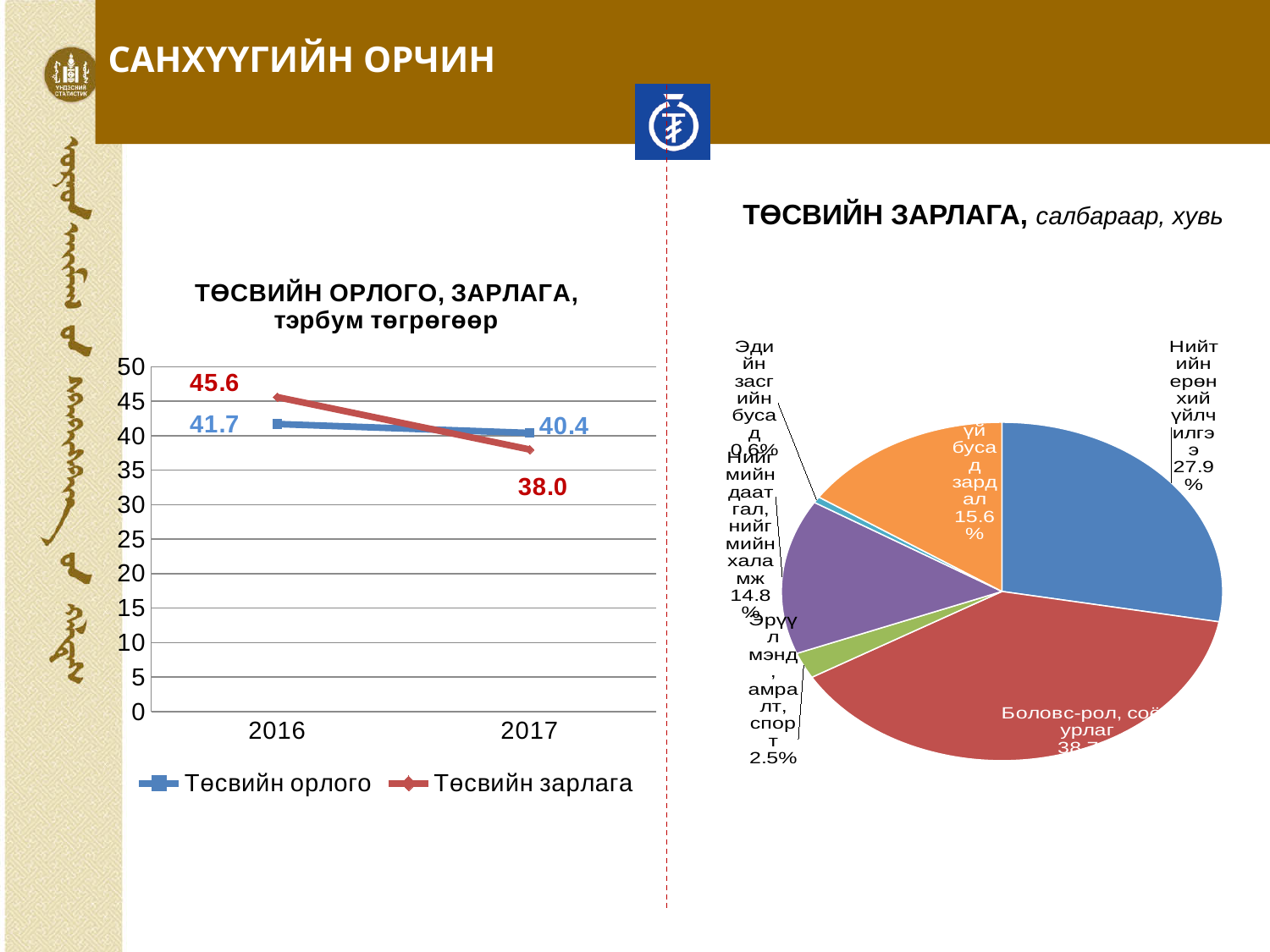
In the pie chart 'ТӨСВИЙН ЗАРЛАГА, салбараар, хувь', which slice is the smallest? Эдийн засгийн бусад In the pie chart 'ТӨСВИЙН ЗАРЛАГА, салбараар, хувь', what share does Нийтийн ерөнхий үйлчилгээ have? 27.9% In the line chart 'ТӨСВИЙН ОРЛОГО, ЗАРЛАГА', which series has the higher value in 2017? Төсвийн орлого In the line chart 'ТӨСВИЙН ОРЛОГО, ЗАРЛАГА', what is the value of Төсвийн зарлага in 2016? 45.6 In the line chart 'ТӨСВИЙН ОРЛОГО, ЗАРЛАГА', does Төсвийн орлого rise or fall from 2016 to 2017? fall In the line chart 'ТӨСВИЙН ОРЛОГО, ЗАРЛАГА', what is the value of Төсвийн зарлага in 2017? 38.0 In the pie chart 'ТӨСВИЙН ЗАРЛАГА, салбараар, хувь', what is the difference between the shares of Нийгмийн даатгал, нийгмийн халамж and Эрүүл мэнд, амралт, спорт? 12.3% In the pie chart 'ТӨСВИЙН ЗАРЛАГА, салбараар, хувь', what share does Бусад зардал have? 15.6% How many series does the legend of the line chart 'ТӨСВИЙН ОРЛОГО, ЗАРЛАГА' list? 2 In the line chart 'ТӨСВИЙН ОРЛОГО, ЗАРЛАГА', by how much did Төсвийн зарлага fall from 2016 to 2017? 7.6 What kind of chart is 'ТӨСВИЙН ОРЛОГО, ЗАРЛАГА, тэрбум төгрөгөөр'? line chart In the line chart 'ТӨСВИЙН ОРЛОГО, ЗАРЛАГА', what is the value of Төсвийн орлого in 2016? 41.7